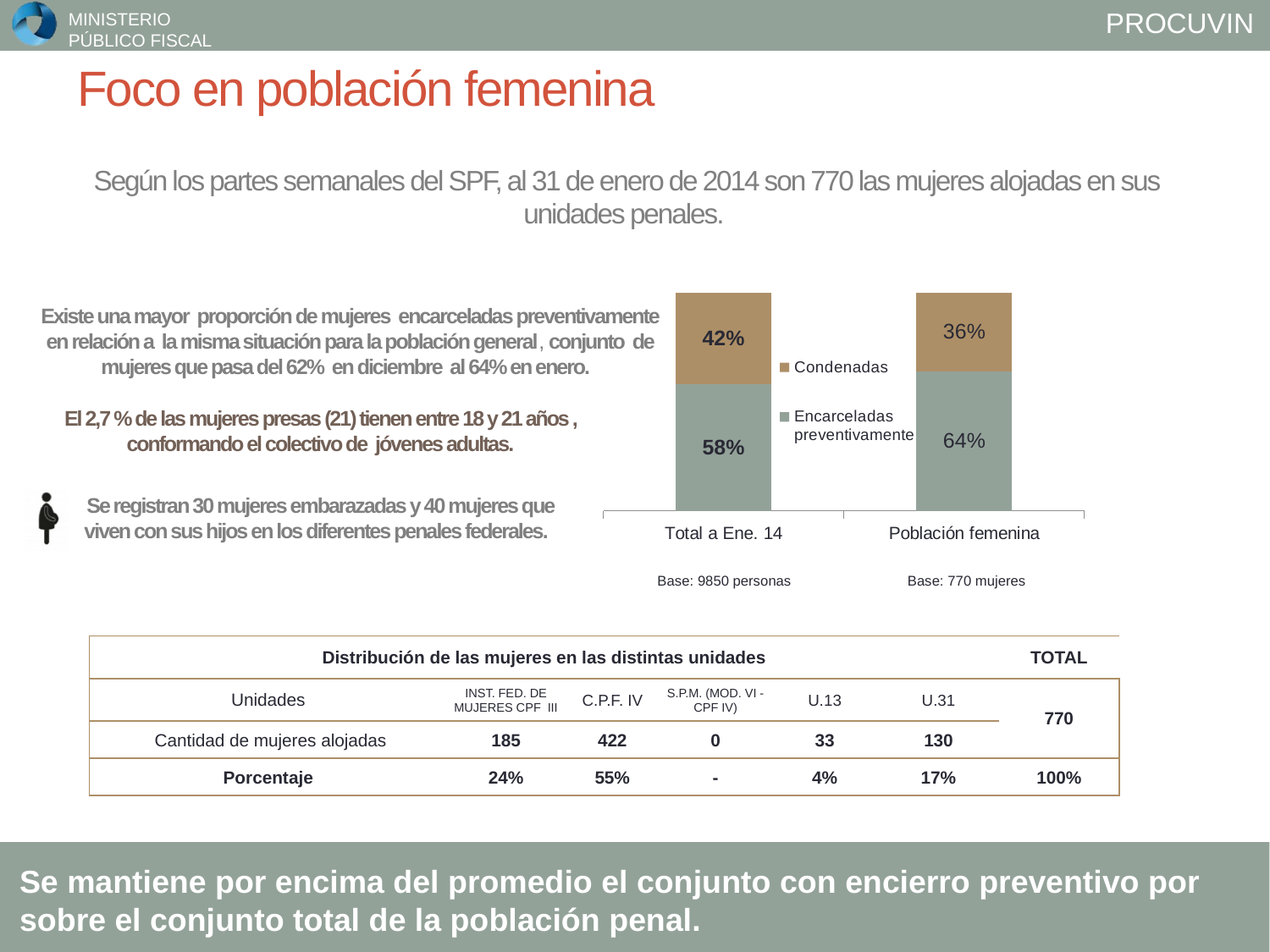
What is the value of Condenadas for Total a Ene. 14? 42% What is the value of Encarceladas preventivamente for Total a Ene. 14? 58% What are the two series named in the chart legend? Condenadas; Encarceladas preventivamente What kind of chart is shown on the slide? Stacked bar chart What is the value of Condenadas for Población femenina? 36% How many series does the legend list? 2 How many categories are shown on the x axis of the chart? 2 Which category has the lower value for Condenadas? Población femenina What is the value of Encarceladas preventivamente for Población femenina? 64% What is the difference between the Encarceladas preventivamente values for Población femenina and Total a Ene. 14? 6% Which category has the higher value for Encarceladas preventivamente? Población femenina Is the Condenadas value for Total a Ene. 14 larger or smaller than the Condenadas value for Población femenina? Larger